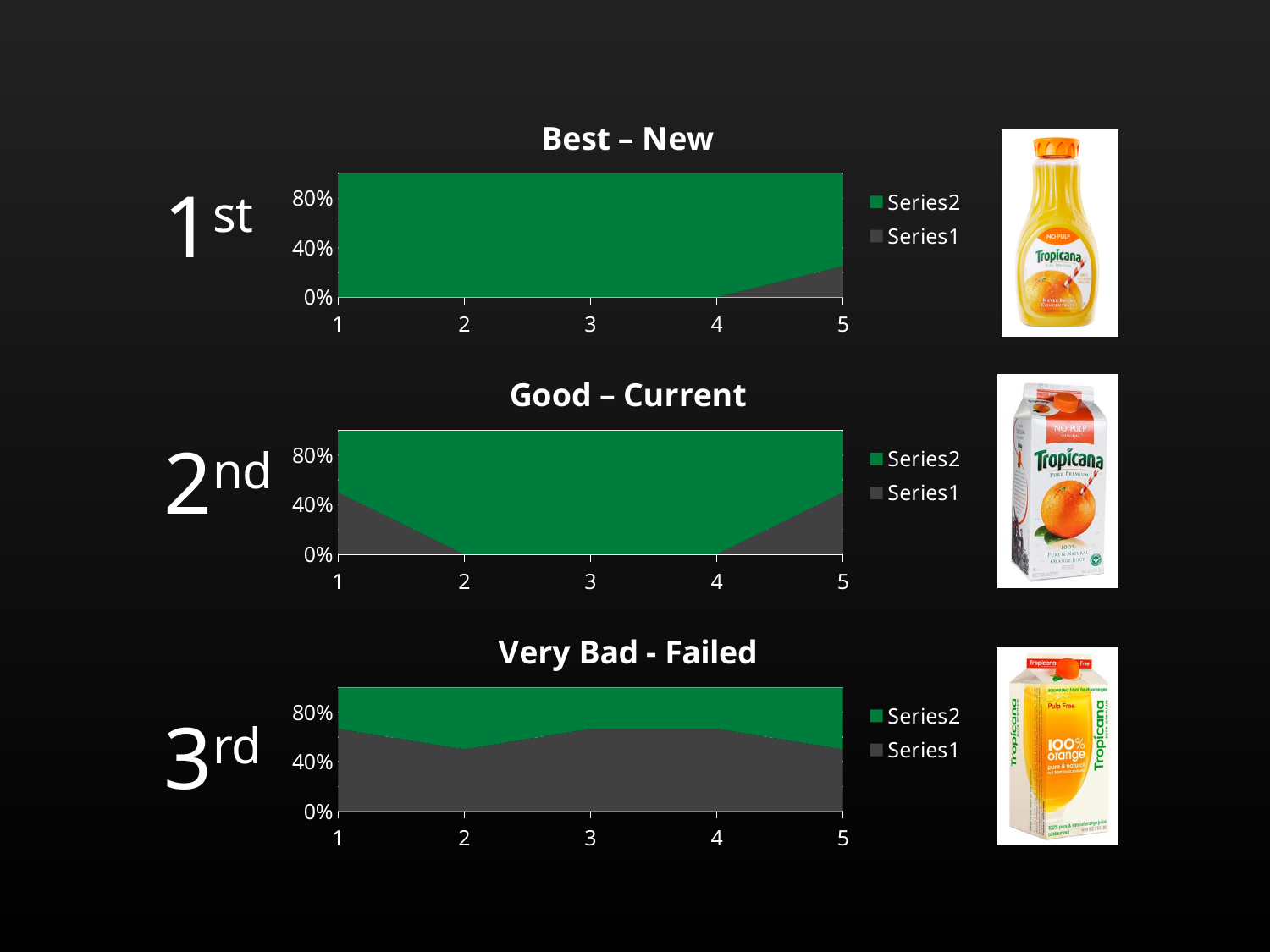
In the 'Very Bad - Failed' chart, is the value of Series1 at category 3 greater or less than 40%? greater In the 'Best – New' chart, is the value of Series1 at category 5 greater or less than 40%? less What kind of chart is the 'Best – New' chart? area chart In the 'Good – Current' chart, what is the value of Series1 at category 3? 0% In the 'Good – Current' chart, is the value of Series1 at category 1 greater or less than 40%? greater What is the title of the chart next to the '2nd' label? Good – Current In the 'Best – New' chart, which colour represents Series2? green How many series does the legend of the 'Good – Current' chart list? 2 In the 'Very Bad - Failed' chart, is Series1 larger at category 2 or at category 3? category 3 In the 'Best – New' chart, what is the value of Series1 at category 1? 0% How many categories are shown on the x axis of the 'Very Bad - Failed' chart? 5